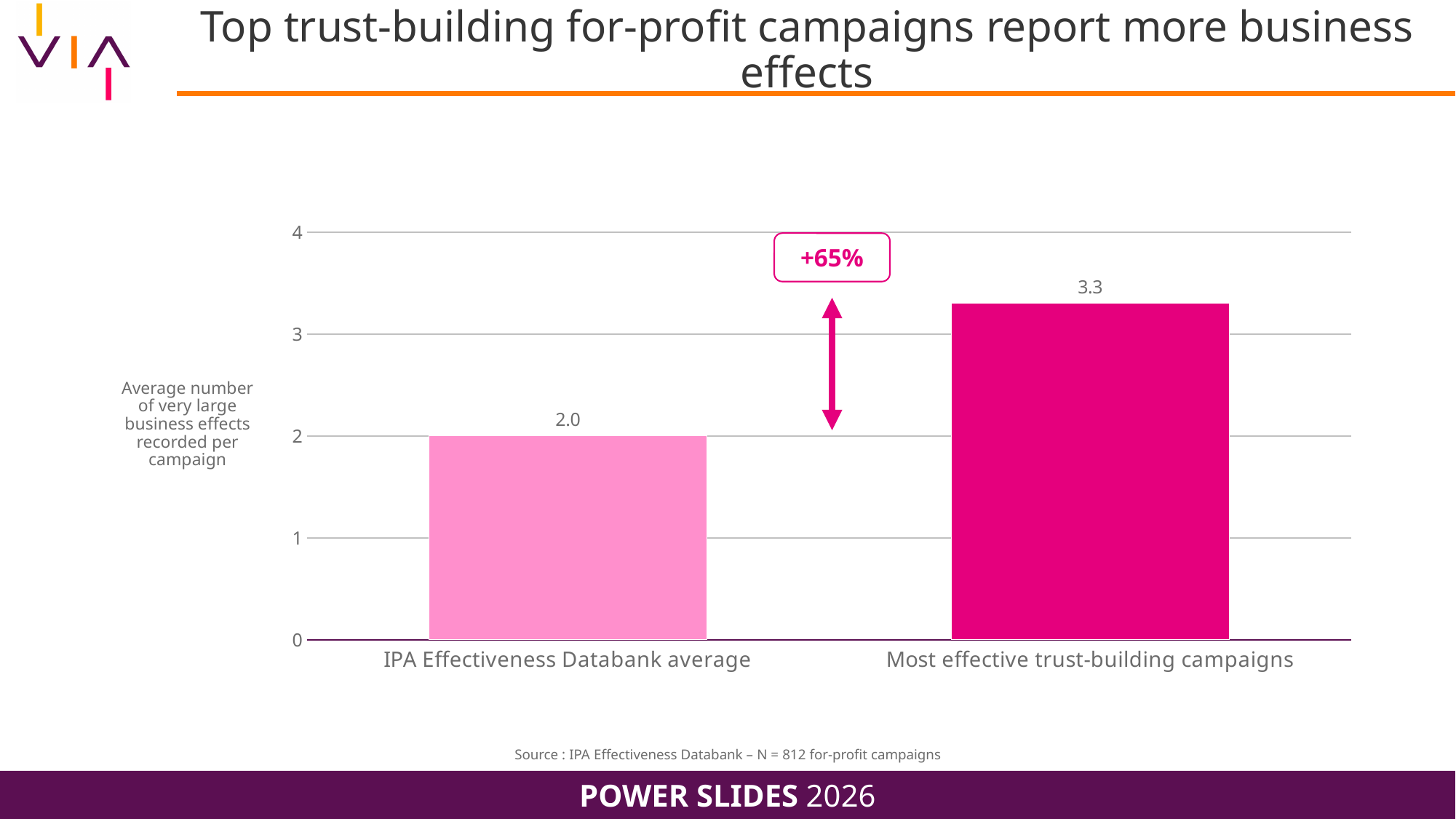
Which is larger, the value for IPA Effectiveness Databank average or the value for Most effective trust-building campaigns? Most effective trust-building campaigns What kind of chart is shown on the slide? bar chart Is the value for Most effective trust-building campaigns greater or less than 3? greater What percentage increase is annotated between the two bars? +65% What is the difference between the values for Most effective trust-building campaigns and IPA Effectiveness Databank average? 1.3 Which category has the lowest value? IPA Effectiveness Databank average How many categories are shown in the chart? 2 What does the y axis of the chart measure? Average number of very large business effects recorded per campaign Do the values rise or fall from left to right across the categories? rise What is the value for Most effective trust-building campaigns? 3.3 Which category has the highest value? Most effective trust-building campaigns What is the value for IPA Effectiveness Databank average? 2.0